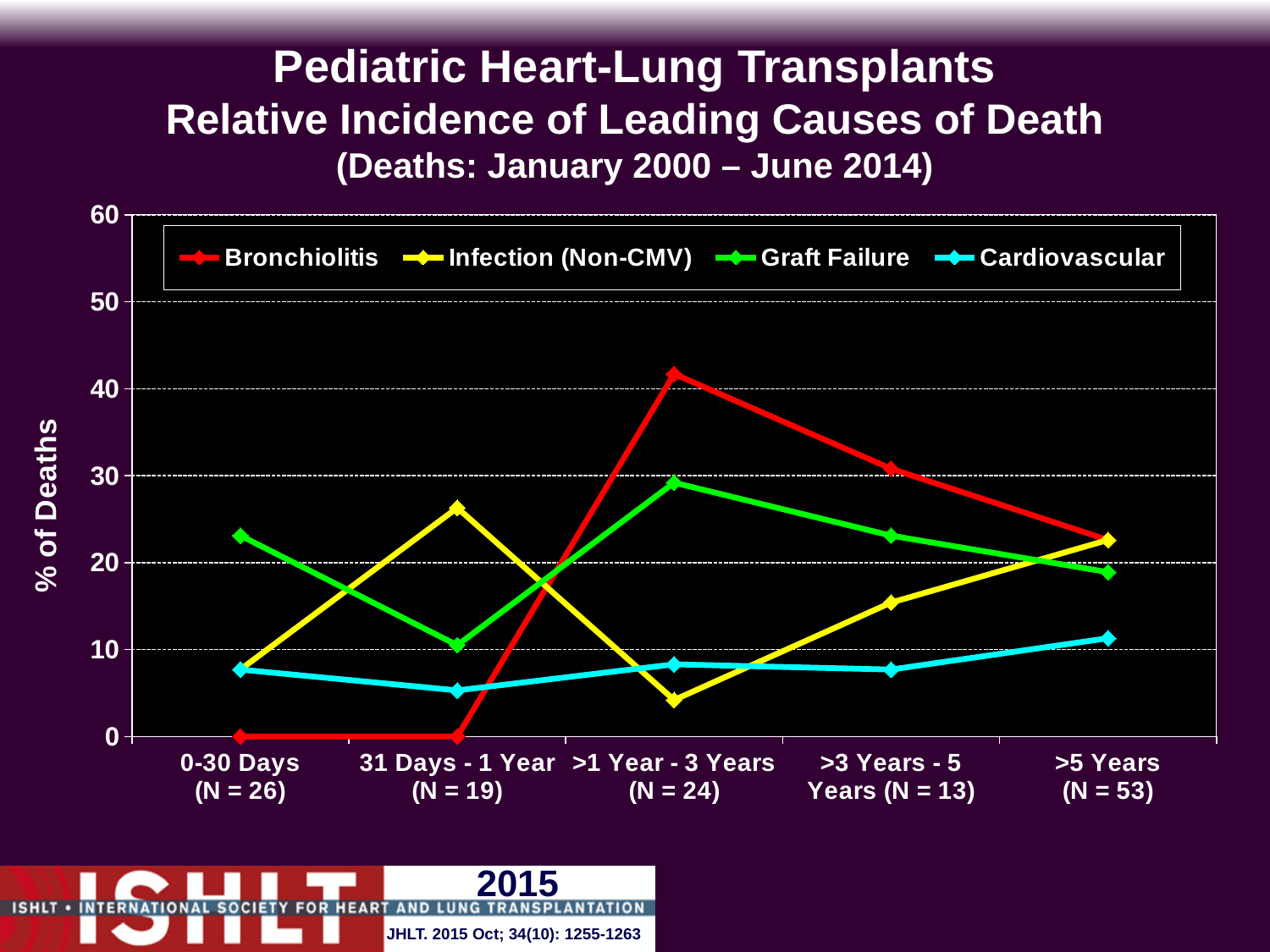
Which cause of death has the highest value in the >1 Year - 3 Years (N = 24) period? Bronchiolitis What is the label on the y axis? % of Deaths Is the value for Bronchiolitis in the >1 Year - 3 Years period greater or less than 40? greater In the 0-30 Days period, which is larger: Graft Failure or Cardiovascular? Graft Failure Which cause of death has the lowest value in the 0-30 Days (N = 26) period? Bronchiolitis What is the value for Bronchiolitis in the 0-30 Days (N = 26) period? 0 What kind of chart is shown on the slide? Line chart Does the Bronchiolitis line rise or fall from the >1 Year - 3 Years period to the >5 Years period? Fall How many time-period categories are shown on the x axis? 5 Is the value for Infection (Non-CMV) in the >1 Year - 3 Years period greater or less than 10? less What is the value for Bronchiolitis in the 31 Days - 1 Year (N = 19) period? 0 How many series does the legend list? 4